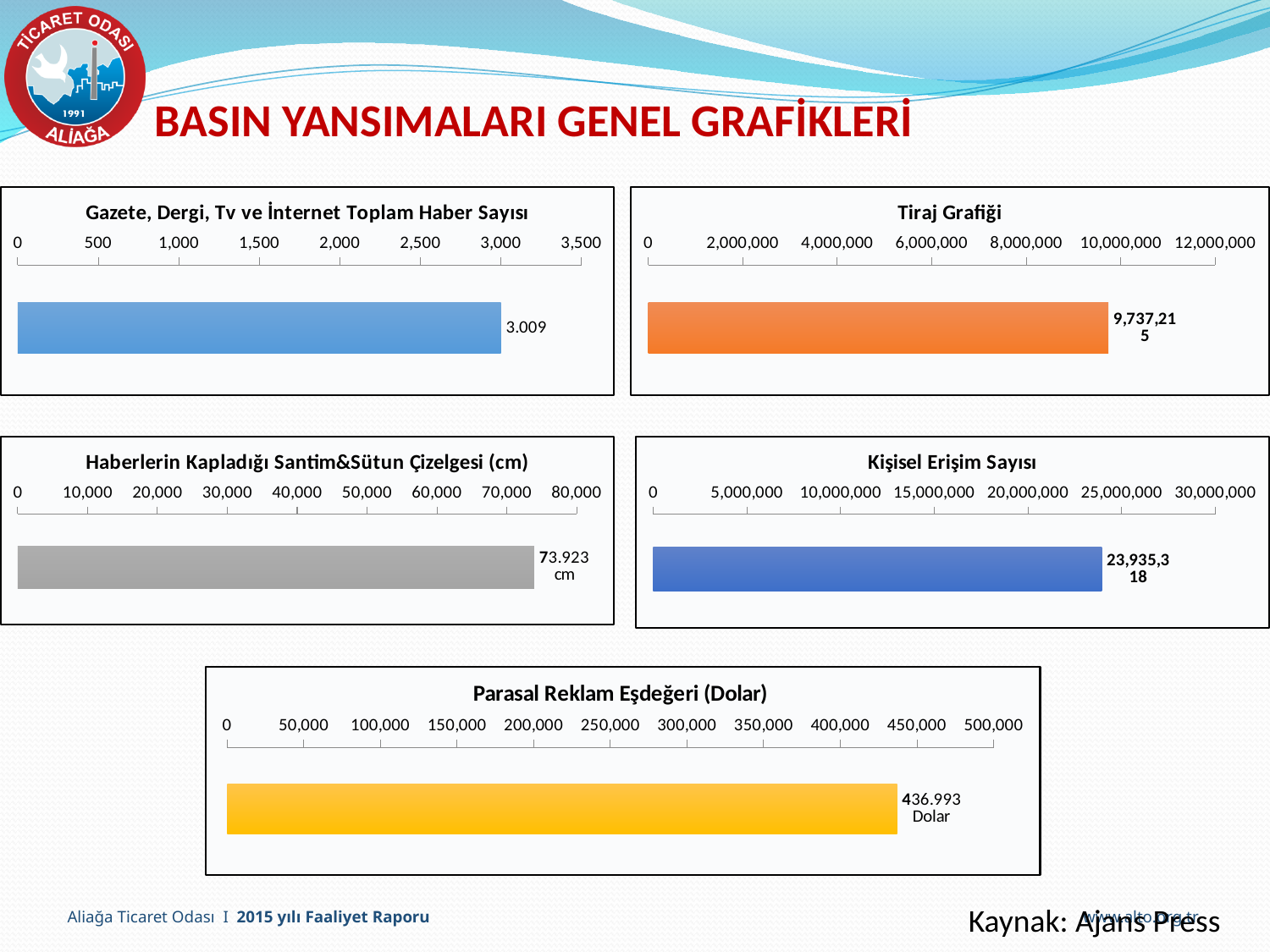
In the chart titled "Gazete, Dergi, Tv ve İnternet Toplam Haber Sayısı", what value is shown on the bar's data label? 3.009 In the "Kişisel Erişim Sayısı" chart, is the bar's value greater or less than 25,000,000? less In the chart titled "Parasal Reklam Eşdeğeri (Dolar)", what value is shown on the bar's data label? 436.993 Dolar What colour is the bar in the "Parasal Reklam Eşdeğeri (Dolar)" chart? yellow How many bars are plotted in the "Kişisel Erişim Sayısı" chart? 1 What kind of chart is the "Tiraj Grafiği" chart? bar chart In the "Tiraj Grafiği" chart, is the bar's value greater or less than 8,000,000? greater In the chart titled "Tiraj Grafiği", what value is shown on the bar's data label? 9,737,215 What is the highest axis tick shown in the "Haberlerin Kapladığı Santim&Sütun Çizelgesi (cm)" chart? 80,000 In the "Parasal Reklam Eşdeğeri (Dolar)" chart, is the bar's value greater or less than 450,000? less In the chart titled "Haberlerin Kapladığı Santim&Sütun Çizelgesi (cm)", what value is shown on the bar's data label? 73.923 cm In the chart titled "Kişisel Erişim Sayısı", what value is shown on the bar's data label? 23,935,318